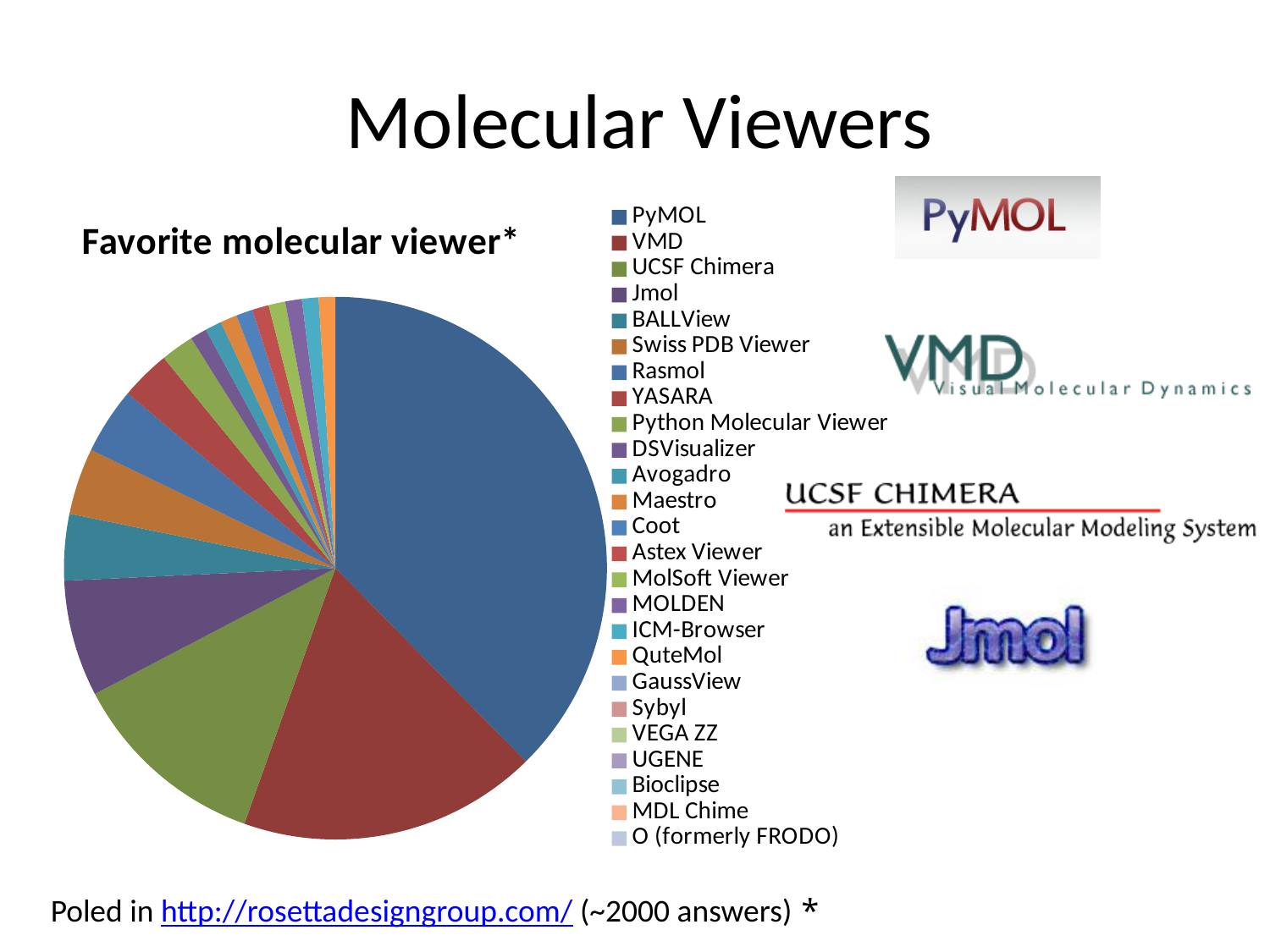
How many molecular viewers are listed in the chart's legend? 25 What is the title of the chart? Favorite molecular viewer* Which has the larger slice, VMD or UCSF Chimera? VMD Which has the larger slice, Jmol or Swiss PDB Viewer? Jmol Which viewer has the second-largest slice of the pie? VMD What kind of chart is shown on the slide? pie chart Which has the larger slice, PyMOL or VMD? PyMOL Which viewer is listed first in the chart's legend? PyMOL Which molecular viewer has the largest slice of the pie? PyMOL